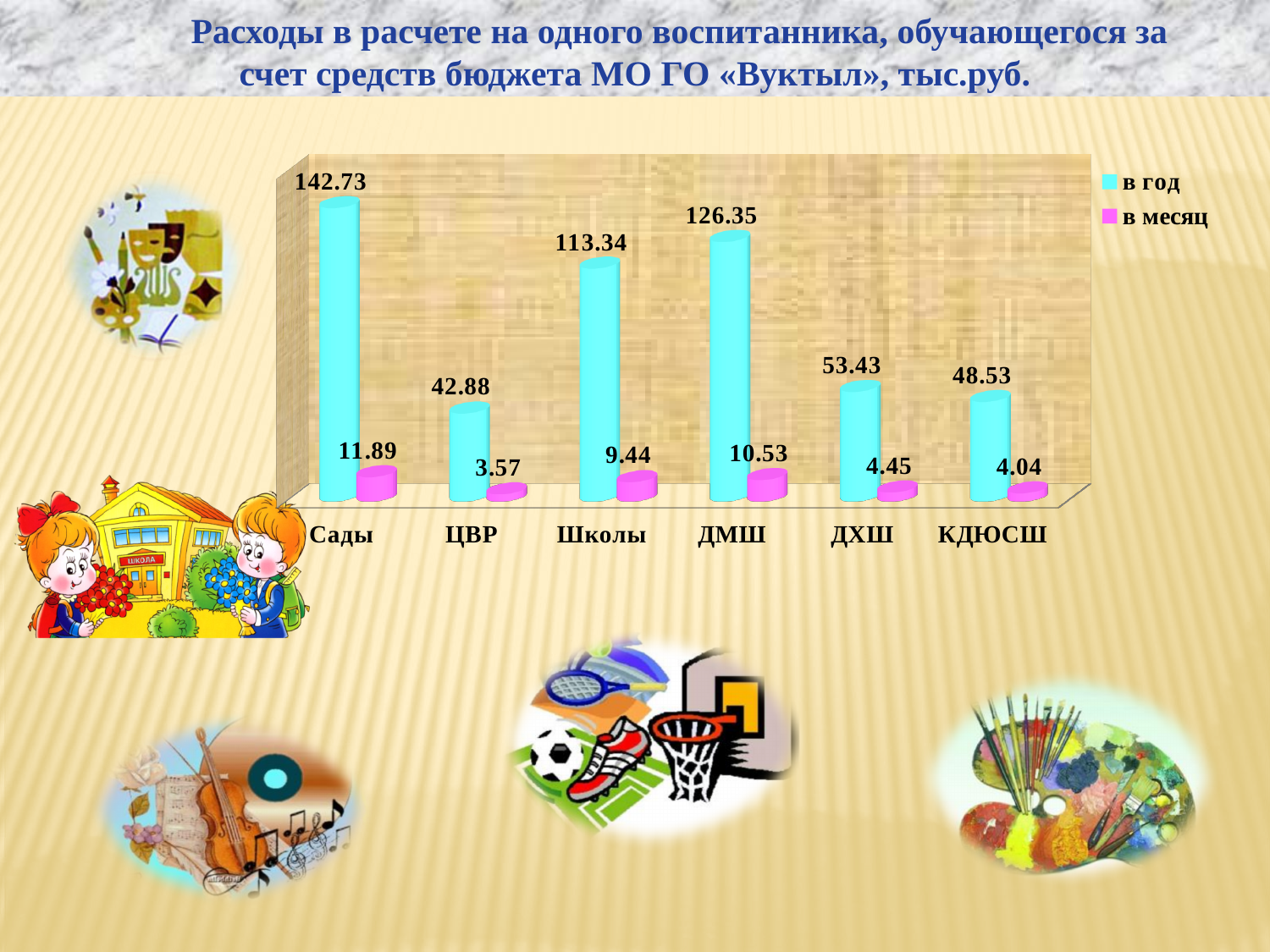
What is the value for ДМШ in the series «в месяц»? 10.53 Which category has the lowest value in the series «в месяц»? ЦВР Which is larger in the series «в год»: ДХШ or КДЮСШ? ДХШ Which category has the highest value in the series «в год»? Сады What is the value for Сады in the series «в год»? 142.73 What is the difference between the «в месяц» values for Сады and ЦВР? 8.32 How many series does the legend list? 2 Which colour represents the series «в месяц» in the legend? Pink What is the value for ЦВР in the series «в год»? 42.88 What is the difference between the «в год» values for Сады and ДМШ? 16.38 How many categories are shown on the x axis? 6 What kind of chart is shown on the slide? Bar chart